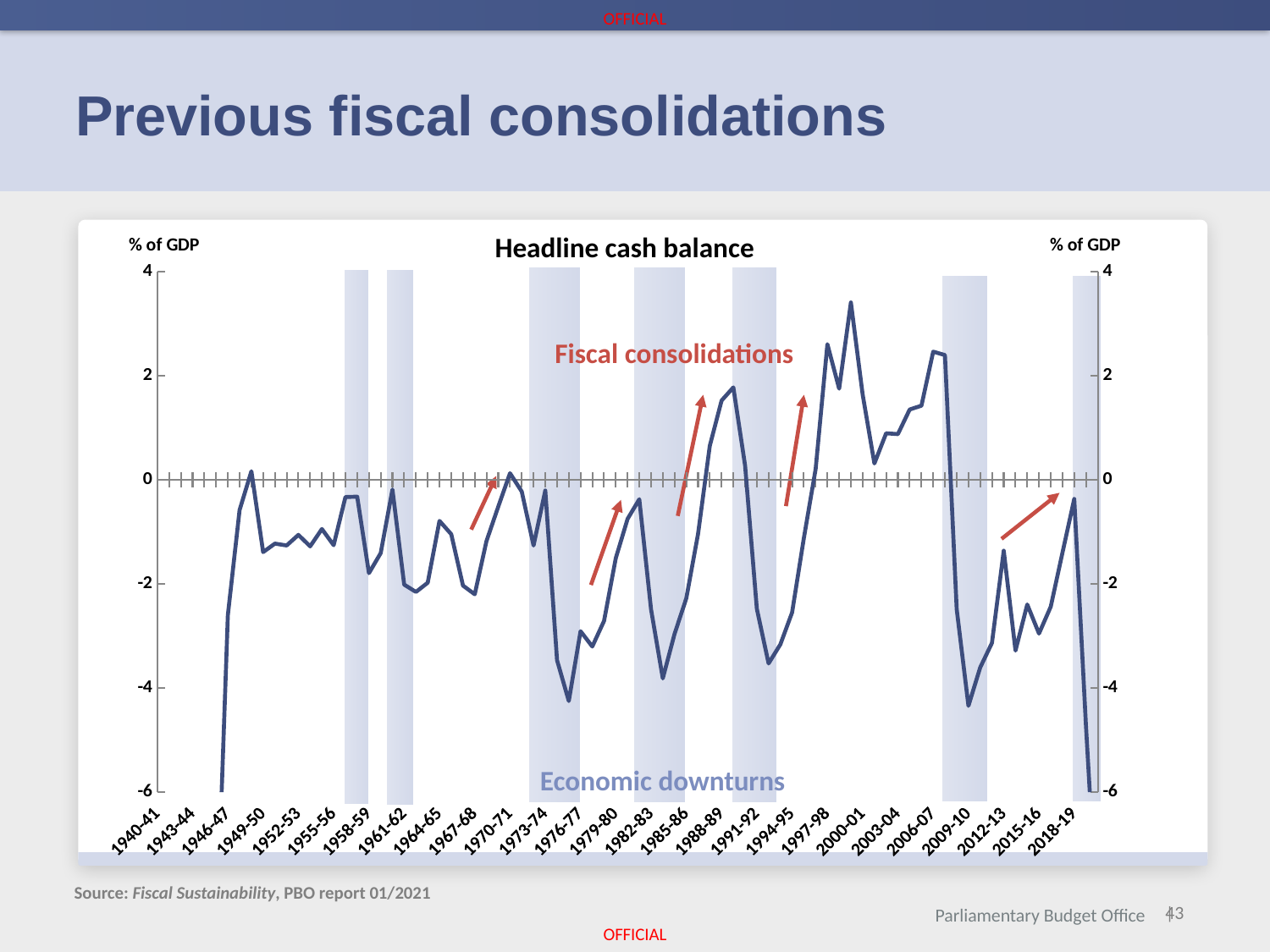
Is the headline cash balance for 2000-01 greater or less than 2? less Which is larger, the headline cash balance for 1946-47 or for 1949-50? 1949-50 Does the headline cash balance rise or fall between 1997-98 and 2000-01? fall Is the headline cash balance for 2009-10 greater or less than -2? less Is the headline cash balance for 1946-47 greater or less than -4? greater What type of chart is shown on the slide? line chart Does the headline cash balance rise or fall between 2006-07 and 2009-10? fall Which is larger, the headline cash balance for 2000-01 or for 2018-19? 2000-01 What is the title of the chart? Headline cash balance According to the chart's annotation, what do the shaded vertical bands represent? Economic downturns